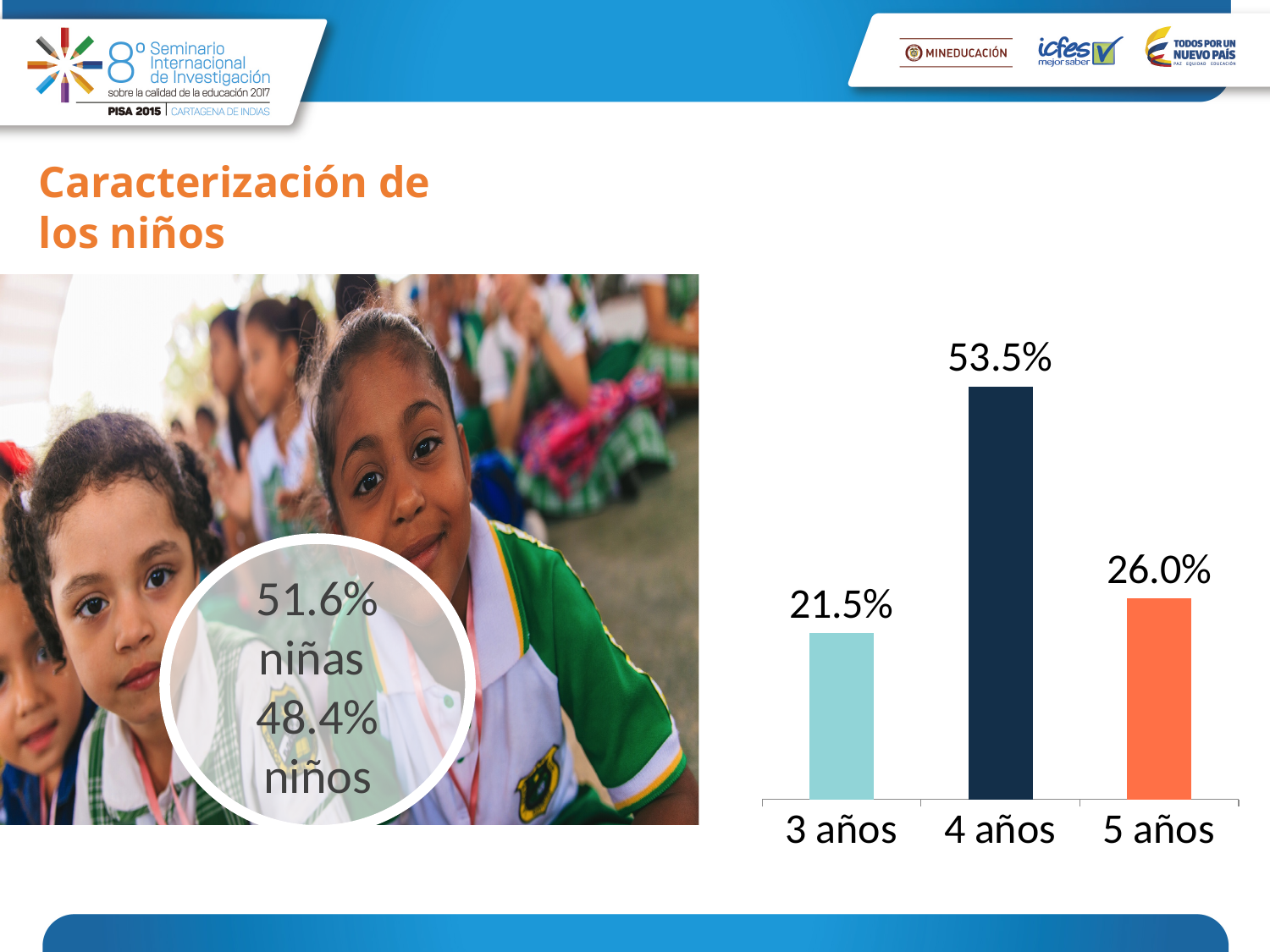
What colour is the bar for 4 años? dark navy blue What is the difference between the values for 5 años and 3 años? 4.5% Which age category has the highest value? 4 años Which is larger, the value for 3 años or the value for 5 años? 5 años What is the value for 3 años? 21.5% What is the difference between the values for 4 años and 5 años? 27.5% What is the total of the three percentages shown in the bar chart? 101.0% What is the value for 4 años? 53.5% What kind of chart is shown on the slide? bar chart What is the value for 5 años? 26.0% How many age categories are shown in the chart? 3 Which age category has the lowest value? 3 años